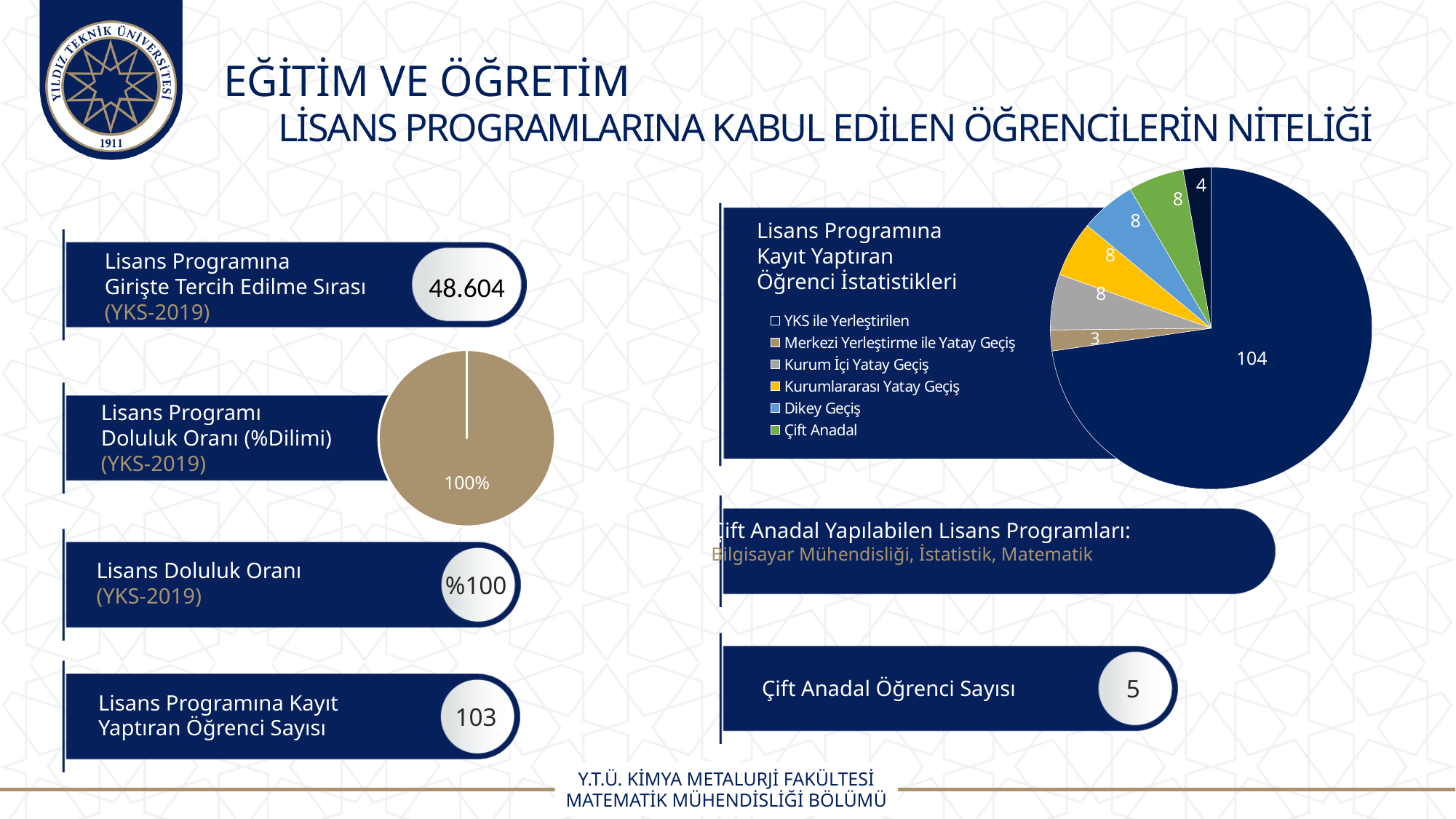
What kind of chart is shown next to 'Lisans Programı Doluluk Oranı (%Dilimi)' on the left of the slide? pie chart How many entries does the legend of the 'Lisans Programına Kayıt Yaptıran Öğrenci İstatistikleri' pie chart list? 6 In the 'Lisans Programına Kayıt Yaptıran Öğrenci İstatistikleri' pie chart, what is the value for Dikey Geçiş? 8 In the 'Lisans Programına Kayıt Yaptıran Öğrenci İstatistikleri' pie chart, what is the value of the largest slice? 104 What kind of chart is the 'Lisans Programına Kayıt Yaptıran Öğrenci İstatistikleri' chart? pie chart In the 'Lisans Programına Kayıt Yaptıran Öğrenci İstatistikleri' pie chart, what is the value for Kurumlararası Yatay Geçiş? 8 In the 'Lisans Programına Kayıt Yaptıran Öğrenci İstatistikleri' pie chart, what is the value for Merkezi Yerleştirme ile Yatay Geçiş? 3 In the 'Lisans Programına Kayıt Yaptıran Öğrenci İstatistikleri' pie chart, which category has the largest slice? YKS ile Yerleştirilen What value is labelled on the 'Lisans Programı Doluluk Oranı (%Dilimi)' pie chart on the left of the slide? 100% In the 'Lisans Programına Kayıt Yaptıran Öğrenci İstatistikleri' pie chart, what is the value for Çift Anadal? 8 In the 'Lisans Programına Kayıt Yaptıran Öğrenci İstatistikleri' pie chart, which is larger: Kurum İçi Yatay Geçiş or Merkezi Yerleştirme ile Yatay Geçiş? Kurum İçi Yatay Geçiş In the 'Lisans Programına Kayıt Yaptıran Öğrenci İstatistikleri' pie chart, what is the difference between the YKS ile Yerleştirilen value and the Merkezi Yerleştirme ile Yatay Geçiş value? 101